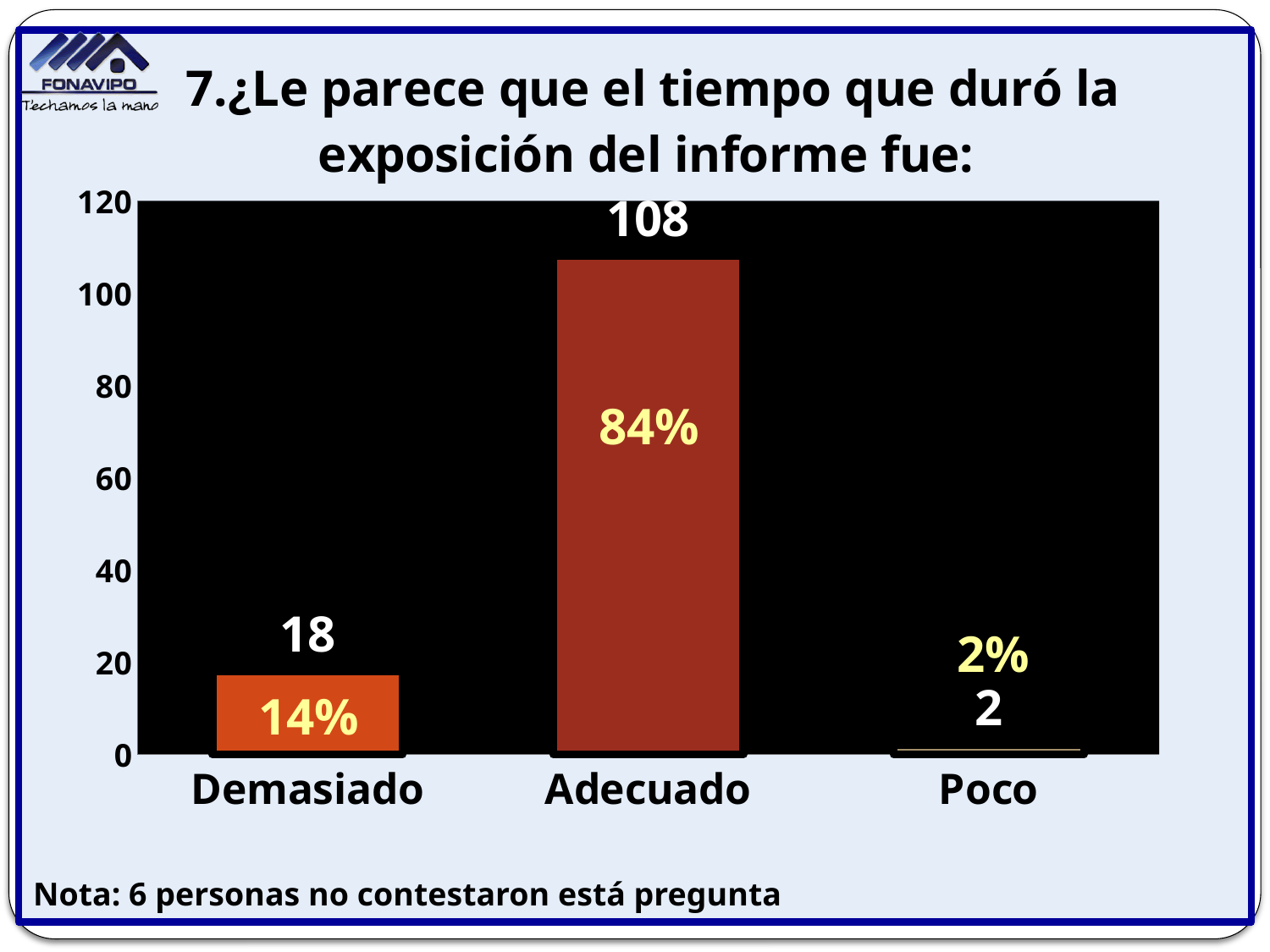
What is the difference between the values for Adecuado and Demasiado? 90 What is the value for Adecuado? 108 Which is larger, the value for Demasiado or the value for Poco? Demasiado Which category has the highest value? Adecuado What kind of chart is shown on the slide? bar chart What is the value for Poco? 2 How many categories are shown on the x axis? 3 What percentage is shown for Adecuado? 84% Which category has the lowest value? Poco Is the value for Adecuado greater or less than 100? greater What percentage is shown for Demasiado? 14% What is the value for Demasiado? 18